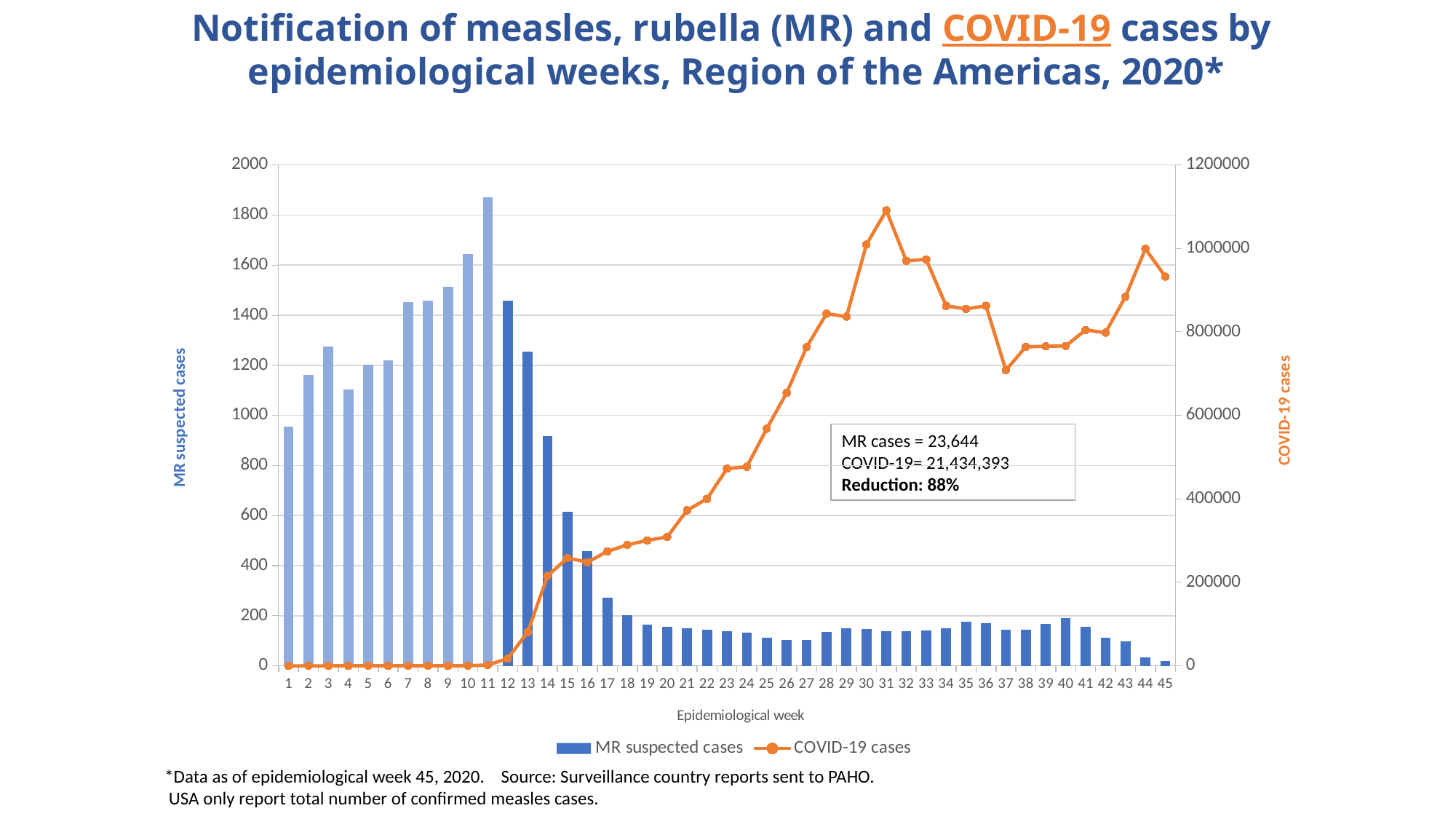
Is the number of MR suspected cases in week 11 greater or less than 1800? greater Do the COVID-19 cases rise or fall from week 12 to week 31? Rise What kind of chart is shown on the slide? A combined bar and line chart How many series does the legend list? 2 Is the number of COVID-19 cases in week 31 greater or less than 1000000? greater According to the text box on the chart, what is the reduction percentage shown? 88% How many epidemiological weeks are plotted on the x axis? 45 In which epidemiological week is the number of MR suspected cases lowest? Week 45 Is the number of COVID-19 cases in week 37 greater or less than 800000? less In which epidemiological week does the COVID-19 cases line reach its peak? Week 31 Which week has more MR suspected cases, week 14 or week 15? Week 14 In which epidemiological week is the number of MR suspected cases highest? Week 11